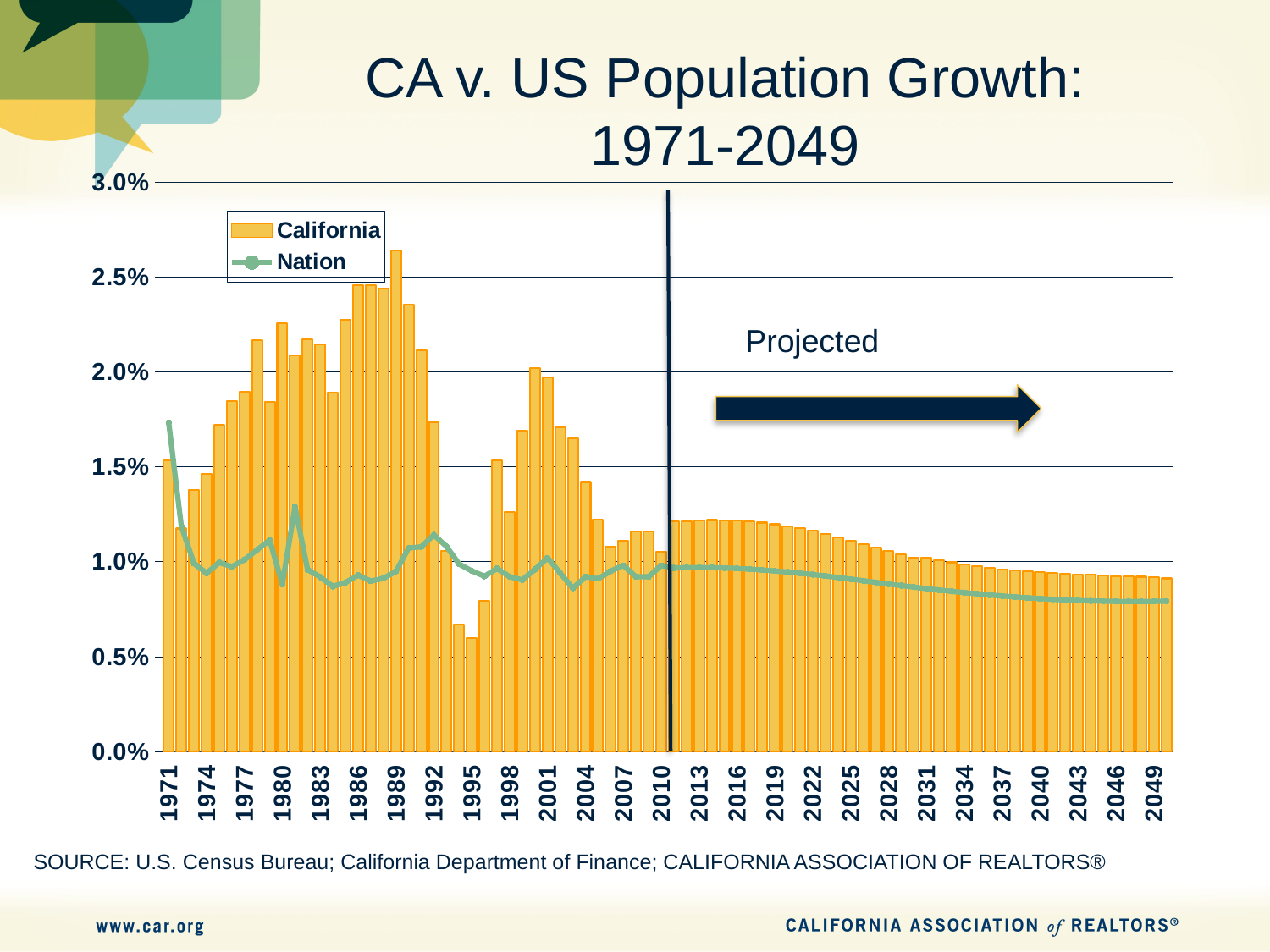
Is the California value for 1995 greater or less than 1.0%? less In 1995, which is larger, the California value or the Nation value? Nation Is the Nation value for 1971 greater or less than 1.5%? greater In 1989, which is larger, the California value or the Nation value? California What label appears to the right of the vertical line after 2010? Projected Which series is shown as bars and which as a line? California is bars; Nation is a line What kind of chart is shown on the slide? A bar chart with a line series In which year is the California bar highest? 1989 How many series does the legend list? 2 Is the California value for 1989 greater or less than 2.5%? greater Do the California values rise or fall from 2016 to 2049? fall